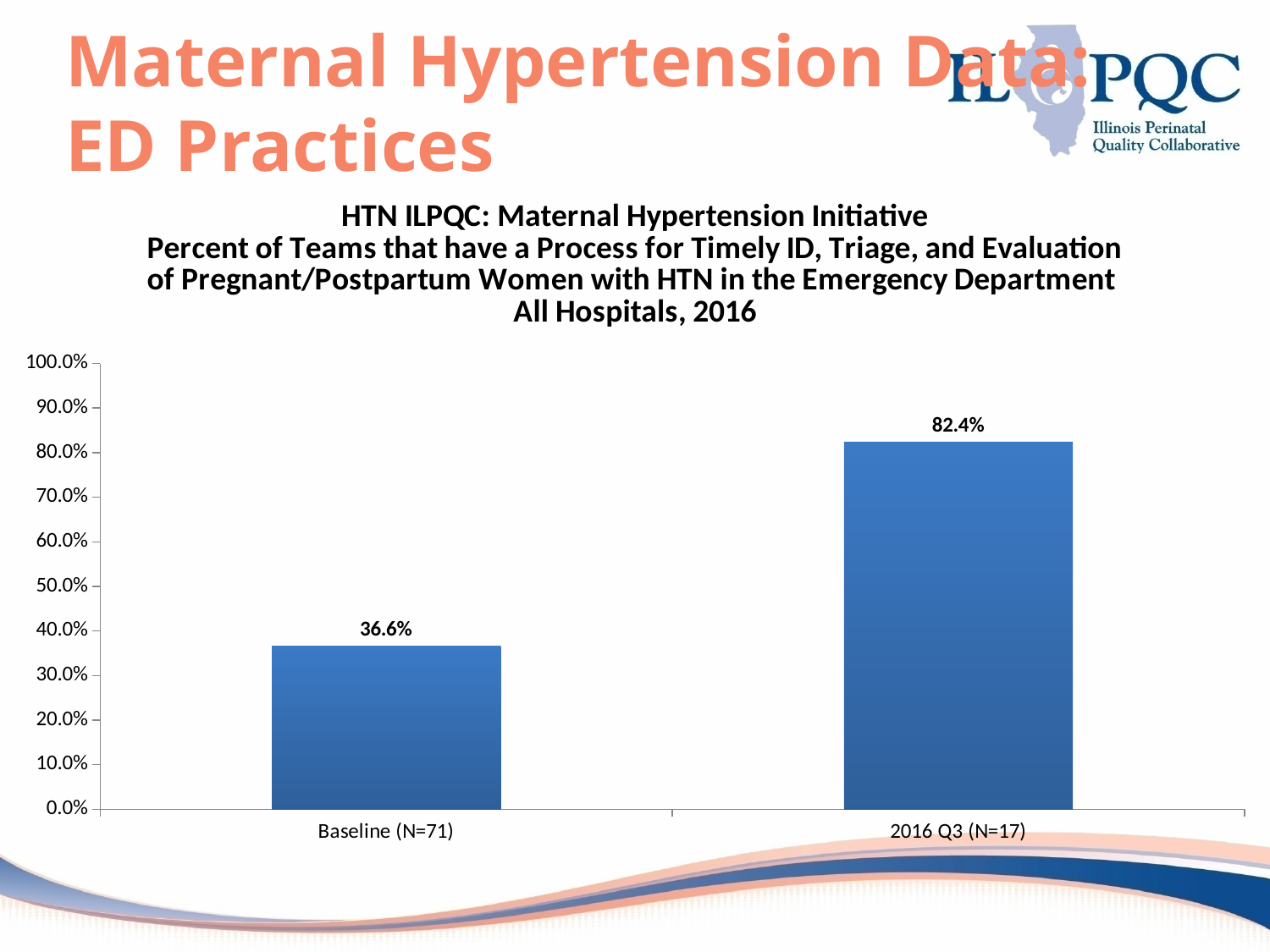
Is the value for 2016 Q3 (N=17) greater or less than 80.0%? greater What is the difference between the 2016 Q3 (N=17) value and the Baseline (N=71) value? 45.8% What is the maximum value shown on the y axis? 100.0% Which is larger, the value for Baseline (N=71) or the value for 2016 Q3 (N=17)? 2016 Q3 (N=17) Is the value for Baseline (N=71) greater or less than 40.0%? less What kind of chart is shown on the slide? bar chart What is the value for 2016 Q3 (N=17)? 82.4% What is the value for Baseline (N=71)? 36.6% Do the values rise or fall from Baseline (N=71) to 2016 Q3 (N=17)? rise Which category has the highest value? 2016 Q3 (N=17) Which category has the lowest value? Baseline (N=71) How many categories are shown on the x axis? 2